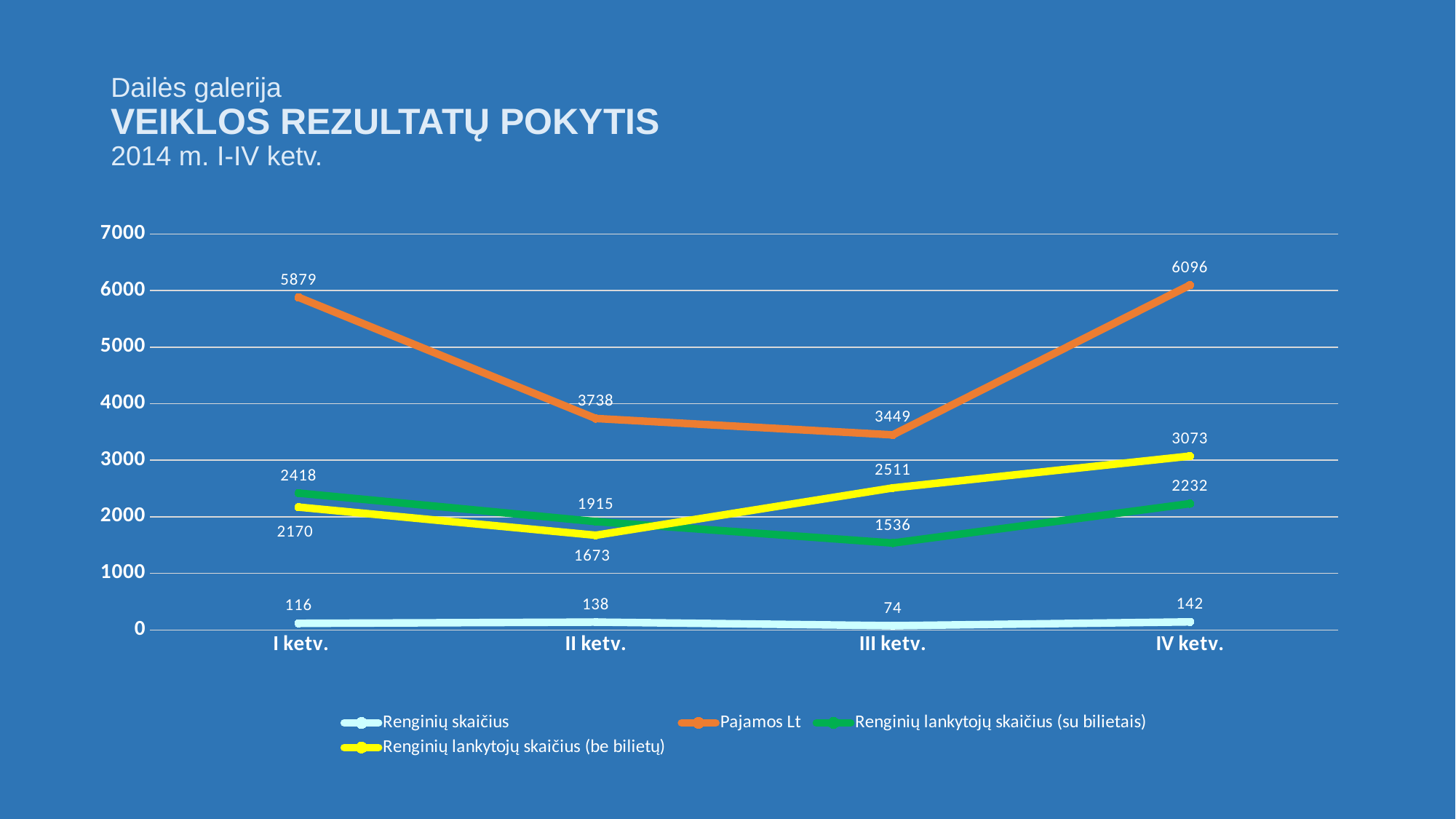
How many series does the legend list? 4 What is the value of Renginių skaičius in II ketv.? 138 What is the difference between Pajamos Lt in IV ketv. and I ketv.? 217 What is the value of Pajamos Lt in IV ketv.? 6096 Does Renginių lankytojų skaičius (be bilietų) rise or fall from II ketv. to IV ketv.? rise Which colour is used for the Pajamos Lt series? orange What type of chart is shown on the slide? line chart Which is larger in II ketv.: Renginių lankytojų skaičius (su bilietais) or Renginių lankytojų skaičius (be bilietų)? Renginių lankytojų skaičius (su bilietais) How many quarters (categories) are plotted on the x axis? 4 What is the value of Renginių lankytojų skaičius (su bilietais) in III ketv.? 1536 In which quarter is Renginių lankytojų skaičius (be bilietų) the highest? IV ketv. In which quarter is Pajamos Lt the lowest? III ketv.